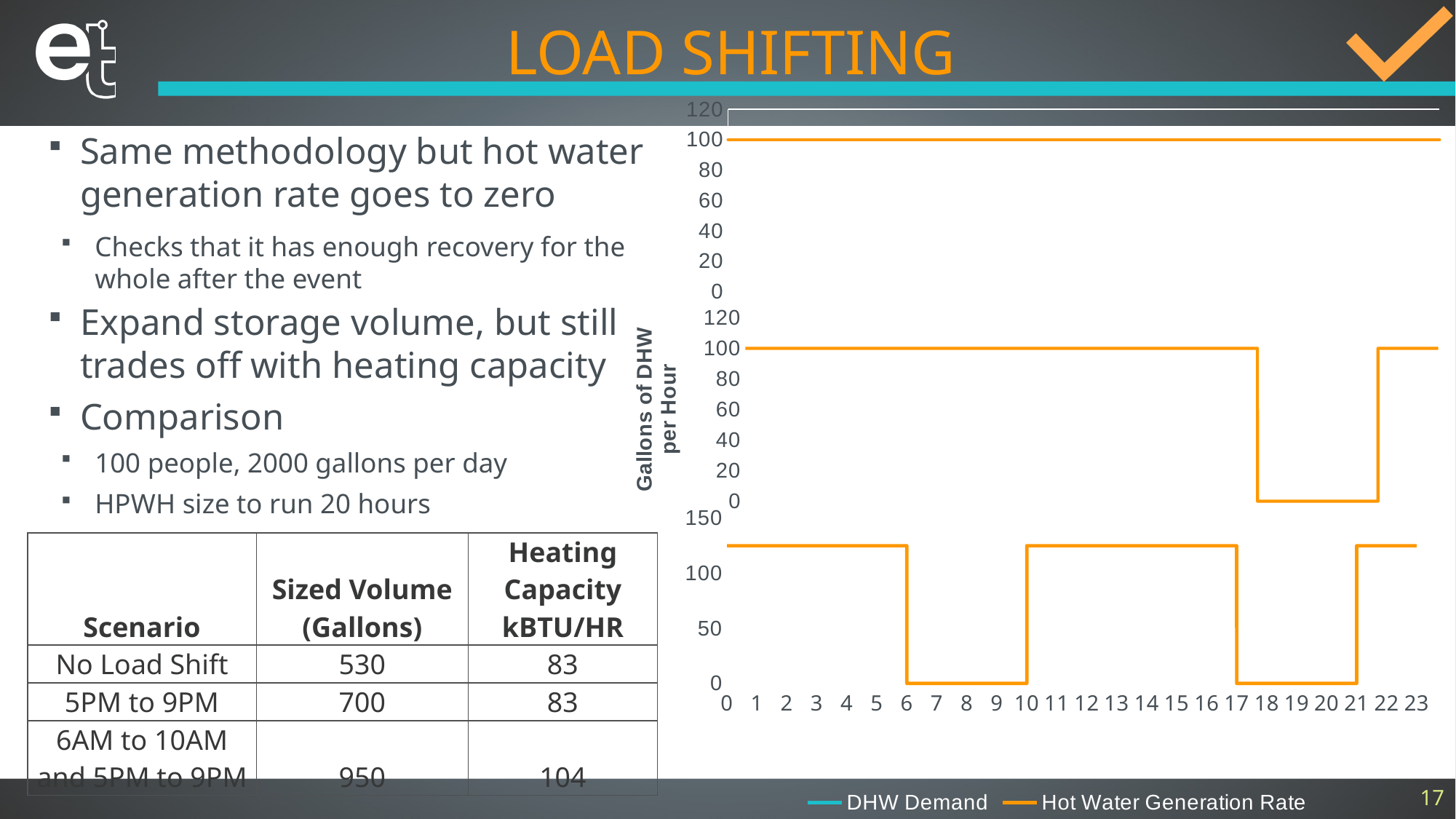
In the bottom chart, is the Hot Water Generation Rate at hour 12 greater or less than 100? greater What kind of chart is the top chart on the right of the slide? line chart In the bottom chart, what is the Hot Water Generation Rate at hour 8? 0 How many series does the legend at the bottom of the slide list? 2 What is the y-axis label shared by the charts on the right of the slide? Gallons of DHW per Hour In the bottom chart, is the Hot Water Generation Rate at hour 3 greater or less than 50? greater In the top chart, what is the Hot Water Generation Rate at hour 5? 100 In the middle chart, what is the Hot Water Generation Rate at hour 10? 100